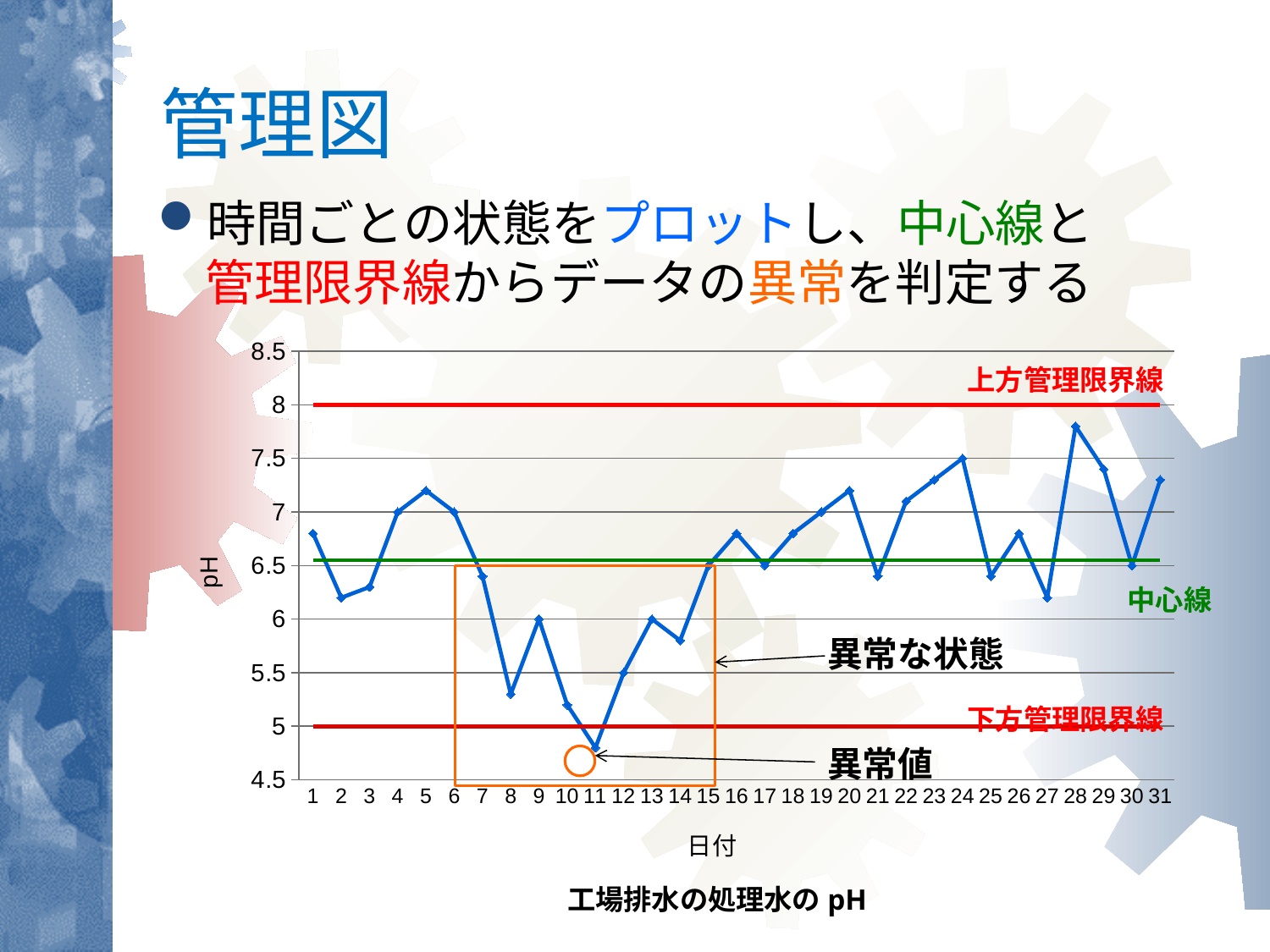
On which date is the pH value the lowest? 11 How many dates (data points) are plotted along the x axis? 31 What kind of chart is shown on the slide? line chart At what pH value is the lower control limit line (下方管理限界線) drawn? 5 On which date is the pH value the highest? 28 Do the pH values rise or fall from date 6 to date 11? fall What is the label of the y axis? pH Is the pH value on date 28 greater or less than 7.5? greater What is the title shown below the chart? 工場排水の処理水の pH Which date has the higher pH value, date 8 or date 24? 24 Is the pH value on date 11 greater or less than 5? less At what pH value is the upper control limit line (上方管理限界線) drawn? 8